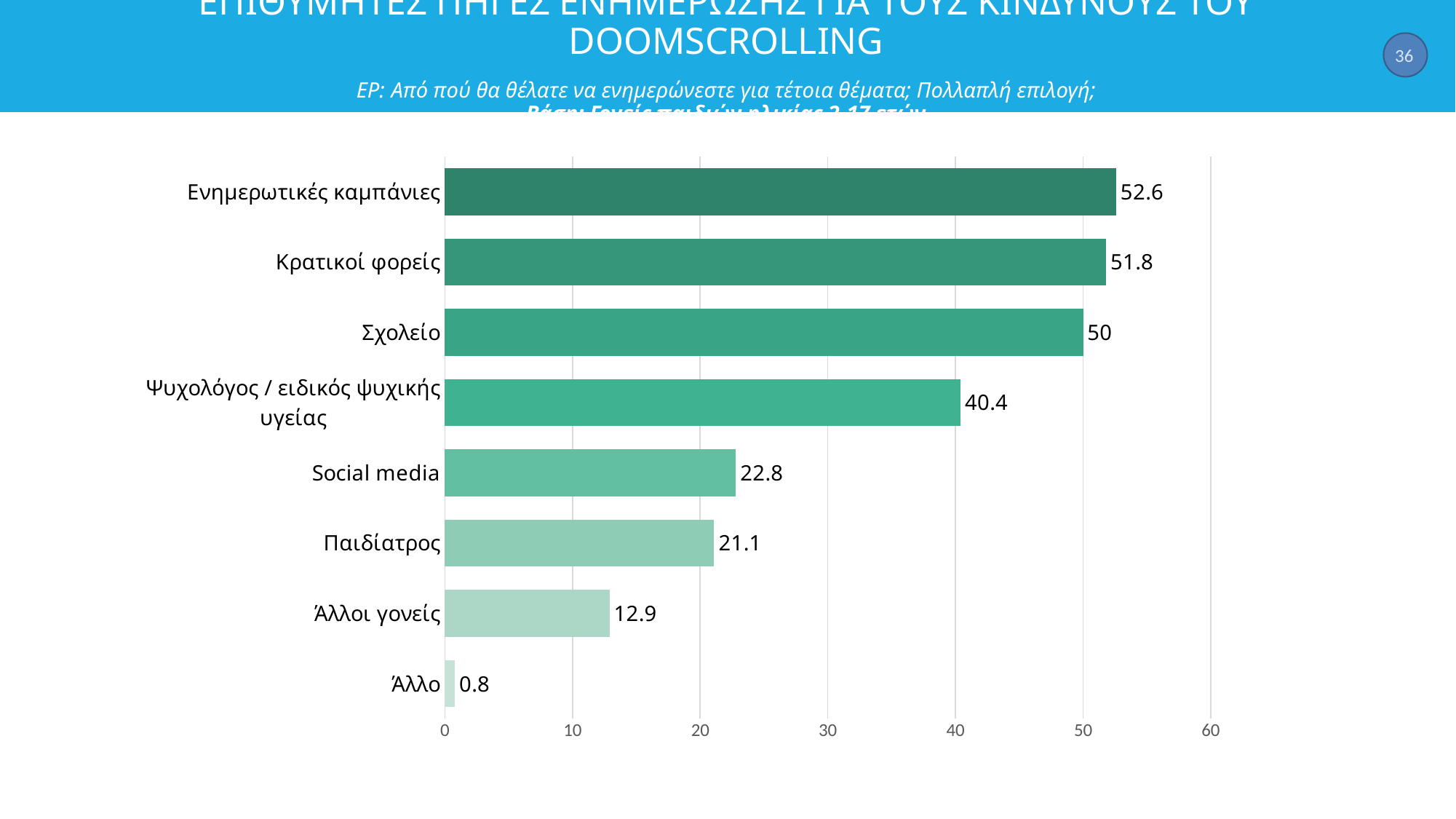
Which is larger, the value for Social media or the value for Παιδίατρος? Social media What is the value for Ψυχολόγος / ειδικός ψυχικής υγείας? 40.4 Which category has the lowest value? Άλλο Is the value for Κρατικοί φορείς greater or less than 50? greater How many categories are shown in the chart? 8 What is the value for Social media? 22.8 What is the value for Ενημερωτικές καμπάνιες? 52.6 Which category has the highest value? Ενημερωτικές καμπάνιες What kind of chart is shown on the slide? bar chart What is the value for Άλλοι γονείς? 12.9 What is the maximum value shown on the horizontal axis? 60 What is the difference between the values for Σχολείο and Παιδίατρος? 28.9